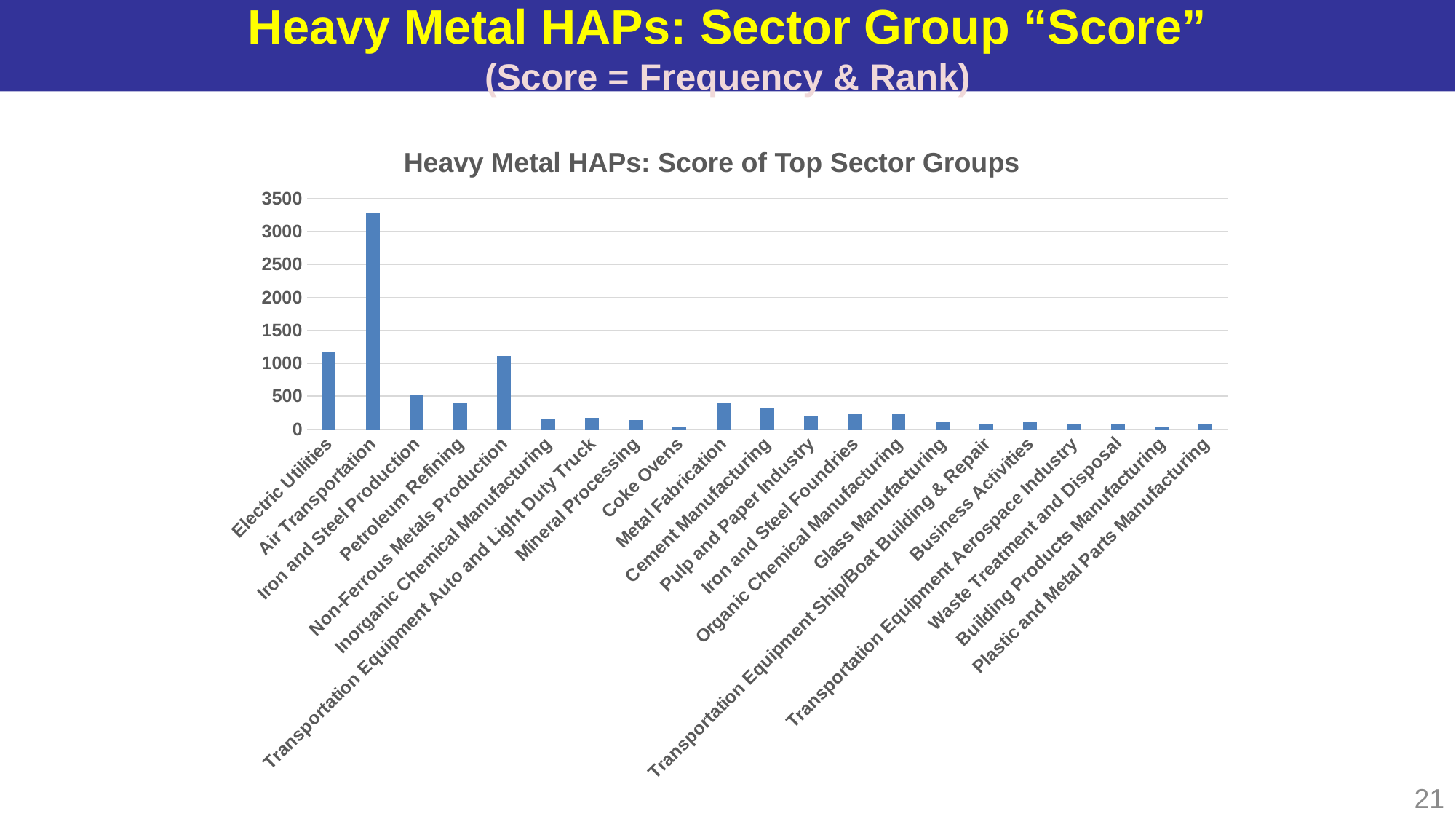
Which has a higher score, Metal Fabrication or Cement Manufacturing? Metal Fabrication Is the value for Air Transportation greater or less than 3000? greater Is the value for Electric Utilities greater or less than 1000? greater Is the value for Metal Fabrication greater or less than 500? less Which sector group has the lowest score? Coke Ovens What kind of chart is shown on the slide? Bar chart Which has a higher score, Electric Utilities or Iron and Steel Production? Electric Utilities What is the highest value shown on the vertical axis? 3500 How many sector groups are plotted on the chart? 21 What is the title of the chart? Heavy Metal HAPs: Score of Top Sector Groups Which sector group has the highest score? Air Transportation